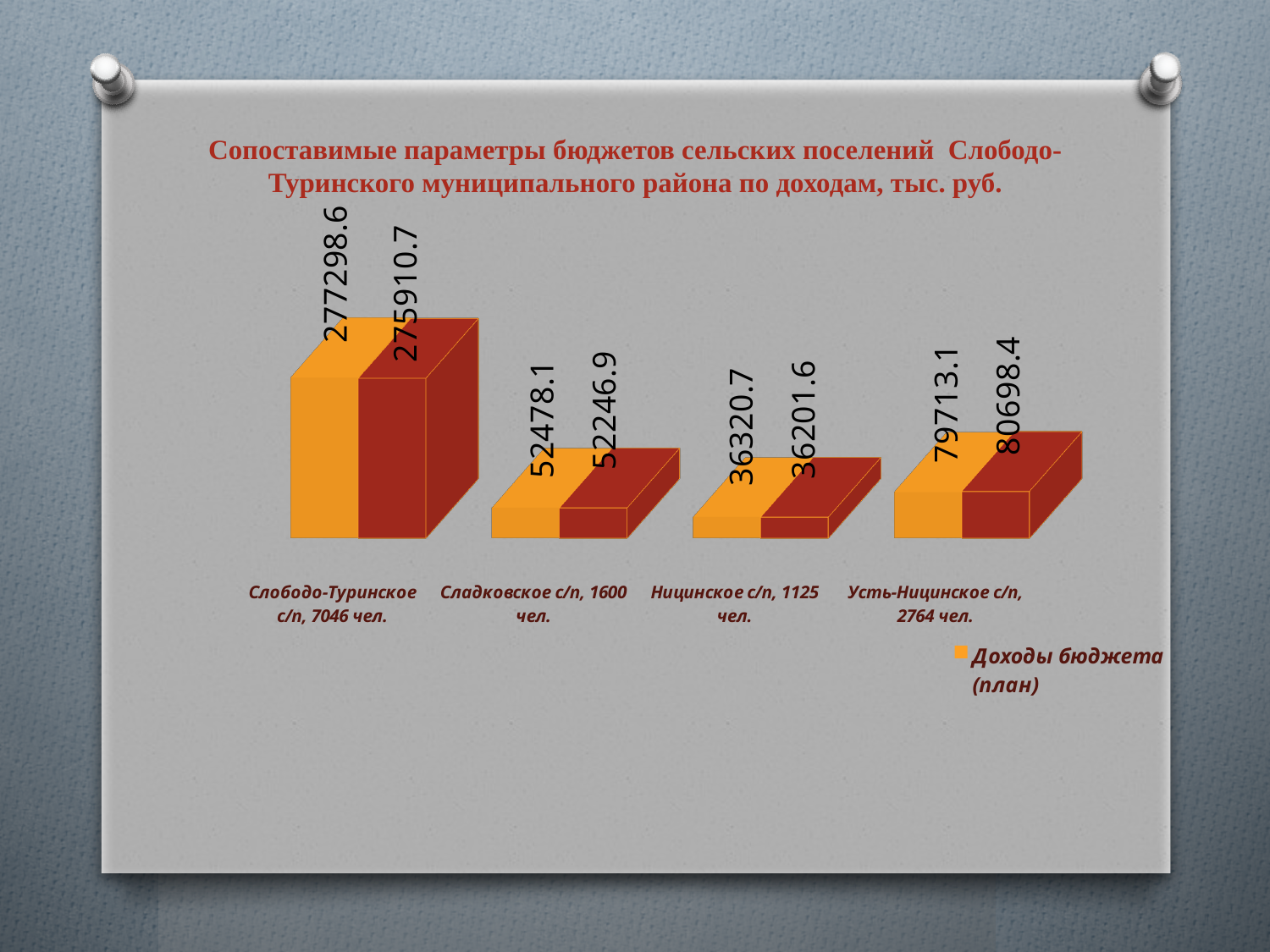
Which settlement has the highest planned budget income? Слободо-Туринское с/п What is the planned budget income (Доходы бюджета (план)) for Ницинское с/п? 36320.7 Which settlement has the lowest planned budget income? Ницинское с/п How many settlements (categories) are shown on the chart? 4 What type of chart is shown on the slide? bar chart What is the difference between the orange and red bars for Слободо-Туринское с/п? 1387.9 What is the difference between the planned budget income of Усть-Ницинское с/п and Ницинское с/п? 43392.4 What is the planned budget income (Доходы бюджета (план)) for Сладковское с/п? 52478.1 Which is larger: the planned budget income of Сладковское с/п or of Усть-Ницинское с/п? Усть-Ницинское с/п What is the value of the red bar for Усть-Ницинское с/п? 80698.4 What is the planned budget income (Доходы бюджета (план)) for Слободо-Туринское с/п? 277298.6 What legend entry is shown for the orange series? Доходы бюджета (план)